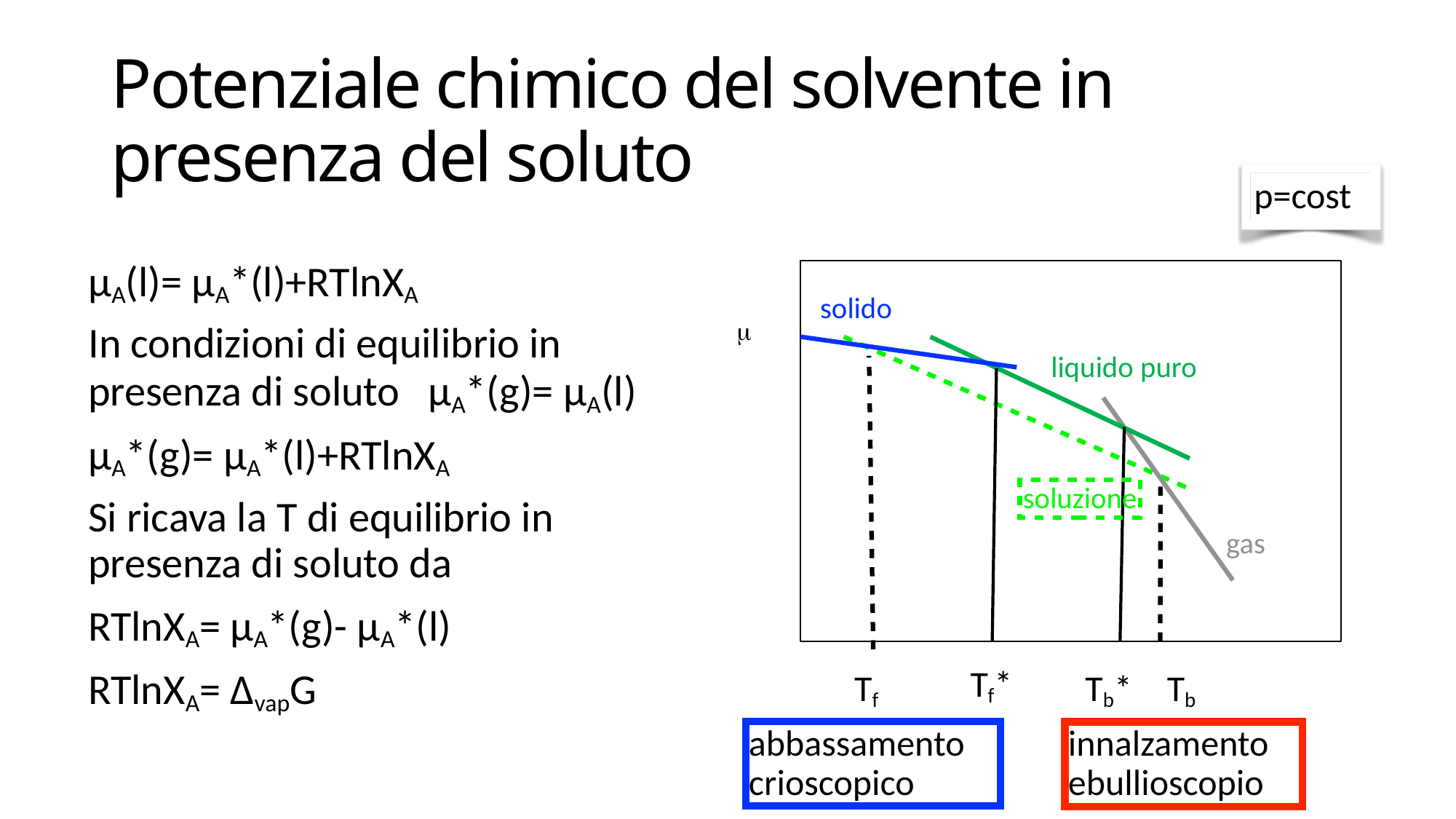
Which of the two temperatures marked on the x axis is further to the right, T_b* or T_b? T_b Which line in the chart lies lower, 'soluzione' or 'liquido puro'? soluzione Do the lines in the chart rise or fall as temperature increases along the x axis? fall What label is written on the y axis of the chart? μ How many labelled lines (phases) are drawn in the chart? 4 Which of the two temperatures marked on the x axis is further to the right, T_f or T_f*? T_f* How many temperature labels are marked along the x axis of the chart? 4 What kind of chart is shown on the slide? line chart What colour is the line labelled 'solido' in the chart? blue